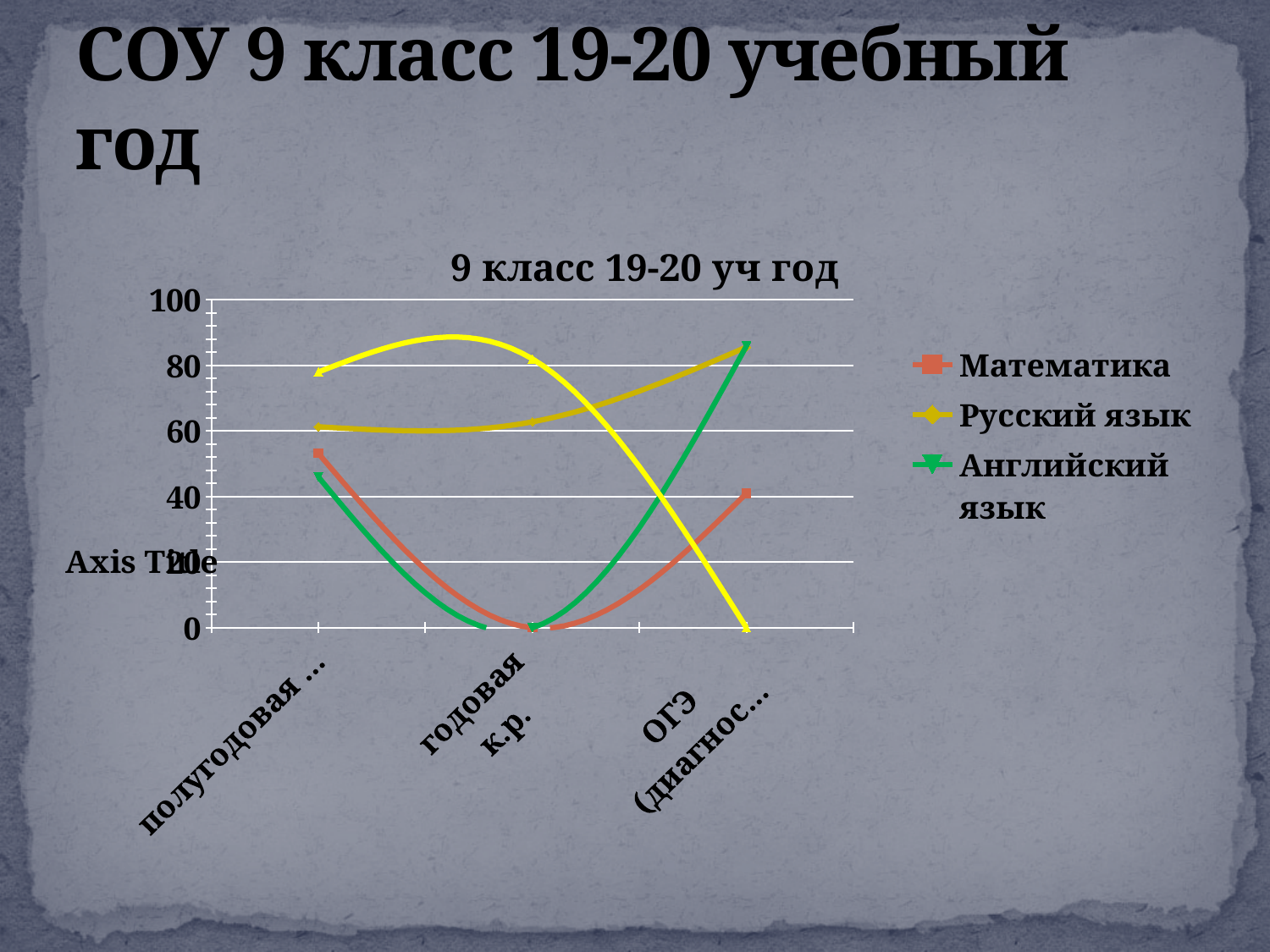
Which series is shown in green in the chart legend? Английский язык At ОГЭ, which is higher: Русский язык or Математика? Русский язык Is the value for Русский язык at ОГЭ greater or less than 80? greater Is the value for Математика at полугодовая greater or less than 60? less Is the value for Английский язык at ОГЭ greater or less than 80? greater How many series does the chart legend list? 3 What kind of chart is shown on the slide? line chart What is the title of the chart? 9 класс 19-20 уч год How many categories are shown on the x axis of the chart? 3 At полугодовая, which is higher: Русский язык or Математика? Русский язык